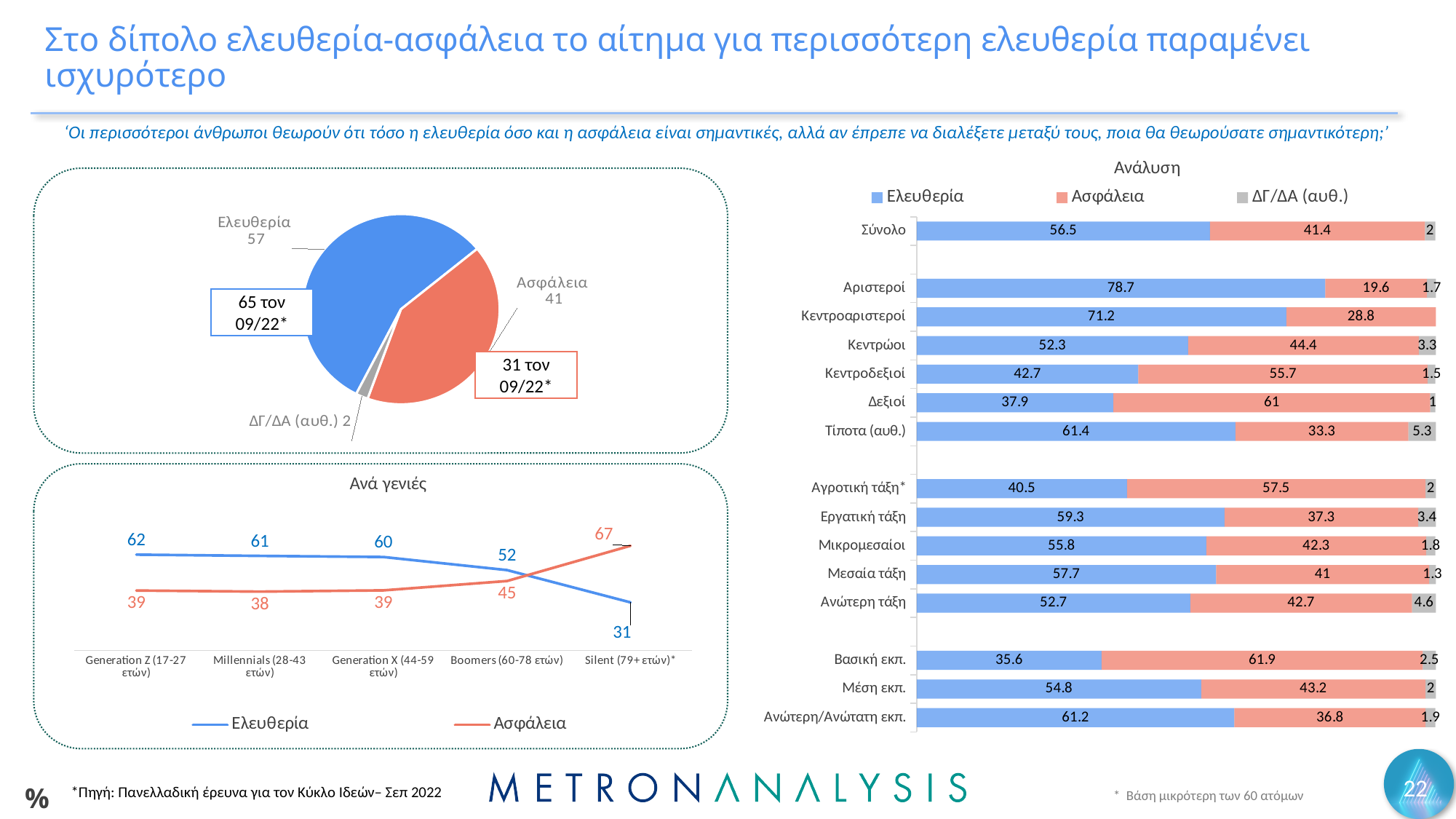
In the 'Ανά γενιές' chart, what is the difference between Ελευθερία and Ασφάλεια for Generation Z (17-27 ετών)? 23 In the 'Ανά γενιές' chart, what is the value of Ασφάλεια for Silent (79+ ετών)? 67 How many series does the legend of the 'Ανάλυση' chart list? 3 In the 'Ανάλυση' chart, which is larger for Δεξιοί: Ελευθερία or Ασφάλεια? Ασφάλεια In the pie chart on the left, what is the value for Ελευθερία? 57 In the pie chart on the left, which slice is the smallest? ΔΓ/ΔΑ (αυθ.) In the 'Ανάλυση' chart, which category has the lowest Ελευθερία value? Βασική εκπ. In the 'Ανά γενιές' chart, does the Ελευθερία line rise or fall from Generation Z to Silent? fall In the 'Ανάλυση' chart, what is the Ελευθερία value for Αριστεροί? 78.7 In the pie chart on the left, what share of the pie does Ασφάλεια take? 41 In the 'Ανά γενιές' chart, how many generation categories are shown on the x axis? 5 What kind of chart is the 'Ανά γενιές' chart? line chart